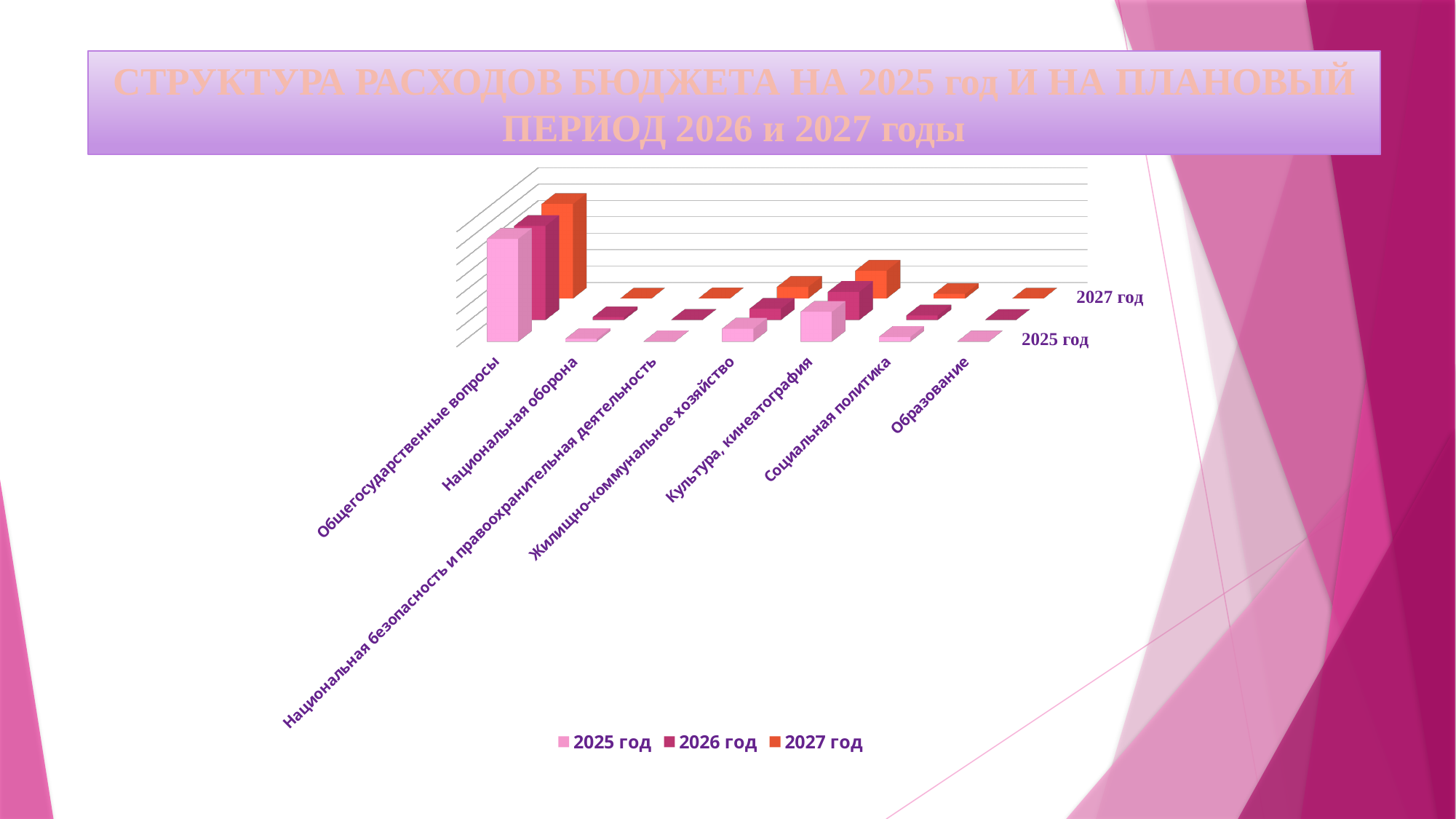
What are the three series listed in the chart's legend? 2025 год, 2026 год, 2027 год Which category has the highest value for the 2027 год series? Общегосударственные вопросы For the 2027 год series, which is larger: Культура, кинематография or Национальная оборона? Культура, кинеатография How many series does the chart's legend list? 3 Which series is shown in orange in the chart's legend? 2027 год Which category has the highest value for the 2025 год series? Общегосударственные вопросы For the 2025 год series, which is larger: Общегосударственные вопросы or Культура, кинематография? Общегосударственные вопросы How many categories are shown on the chart's category axis? 7 For the 2026 год series, which is larger: Жилищно-коммунальное хозяйство or Образование? Жилищно-коммунальное хозяйство Which category has the highest value for the 2026 год series? Общегосударственные вопросы What kind of chart is shown on the slide? bar chart